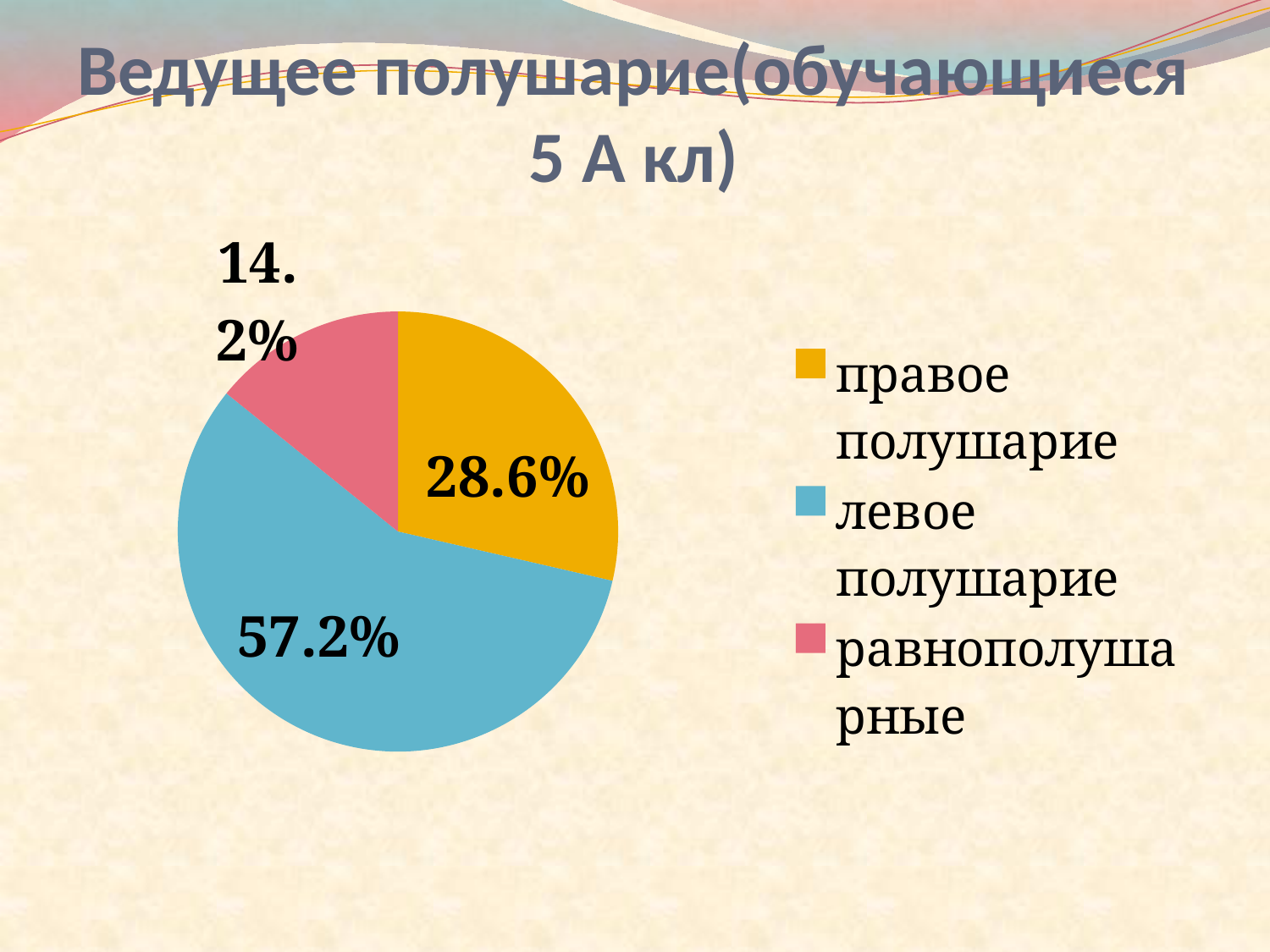
What colour is the slice for левое полушарие? blue What is the value for правое полушарие? 28.6% Which category has the smallest share of the pie? равнополушарные How many slices does the pie chart have? 3 What is the difference between the values for правое полушарие and равнополушарные? 14.4% What is the value for равнополушарные? 14.2% What is the title of the chart? Ведущее полушарие(обучающиеся 5 А кл) What is the difference between the values for левое полушарие and правое полушарие? 28.6% What kind of chart is shown on the slide? pie chart What is the value for левое полушарие? 57.2% Which category has the largest share of the pie? левое полушарие Which is larger, the value for правое полушарие or the value for равнополушарные? правое полушарие